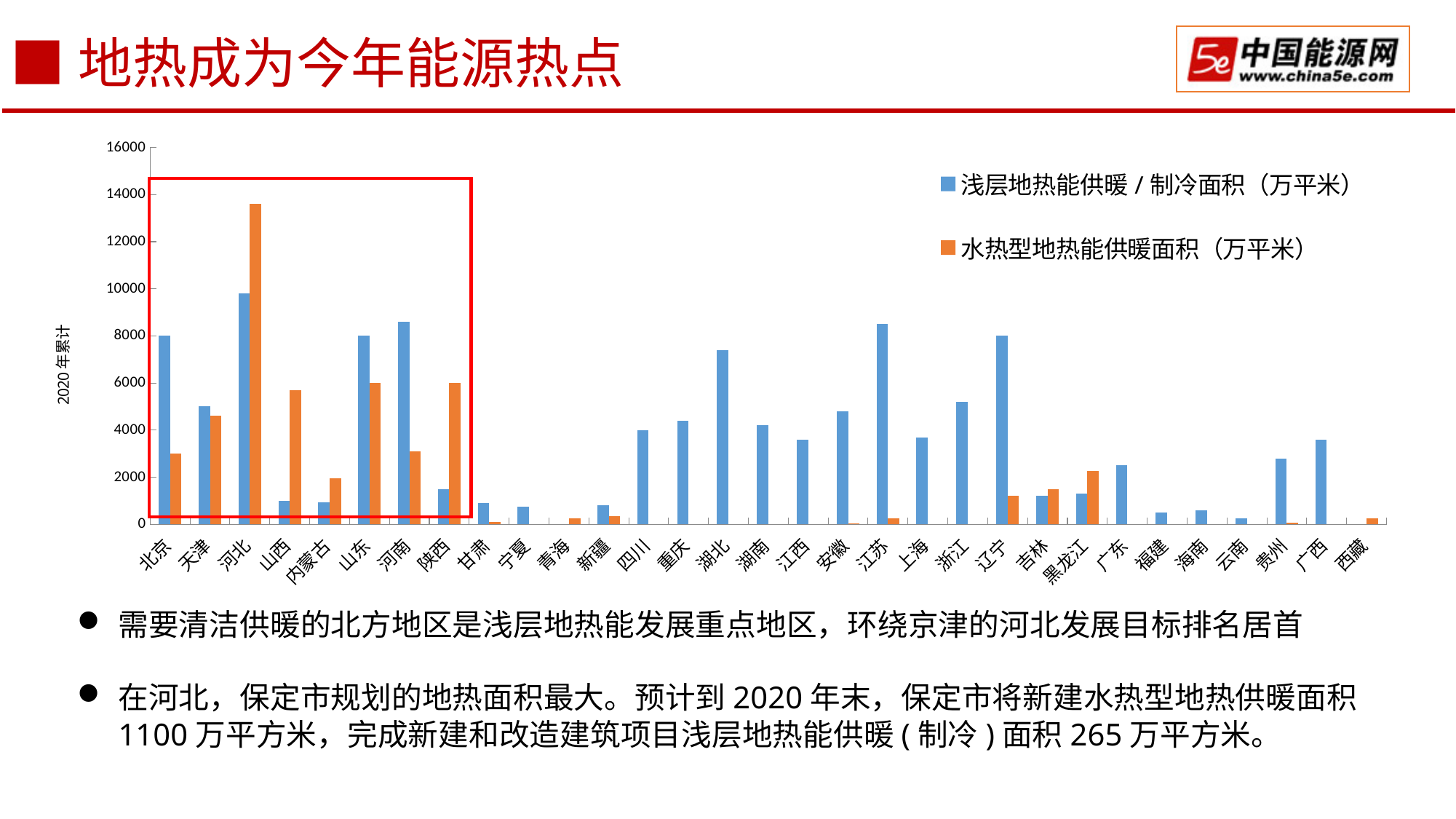
Which region has the highest value for 浅层地热能供暖/制冷面积（万平米）? 河北 How many provinces/regions are shown on the x axis? 31 Is the 水热型地热能供暖面积 value for 河北 greater or less than 12000? greater For 河北, which series has the larger value: 浅层地热能供暖/制冷面积 or 水热型地热能供暖面积? 水热型地热能供暖面积 Is the 浅层地热能供暖/制冷面积 value for 湖北 greater or less than 6000? greater Is the 浅层地热能供暖/制冷面积 value for 广西 greater or less than 4000? less What is the label on the vertical axis of the chart? 2020年累计 How many series does the legend list? 2 Which has the larger 浅层地热能供暖/制冷面积 value, 江苏 or 上海? 江苏 Which region has the highest value for 水热型地热能供暖面积（万平米）? 河北 What kind of chart is shown on the slide? bar chart